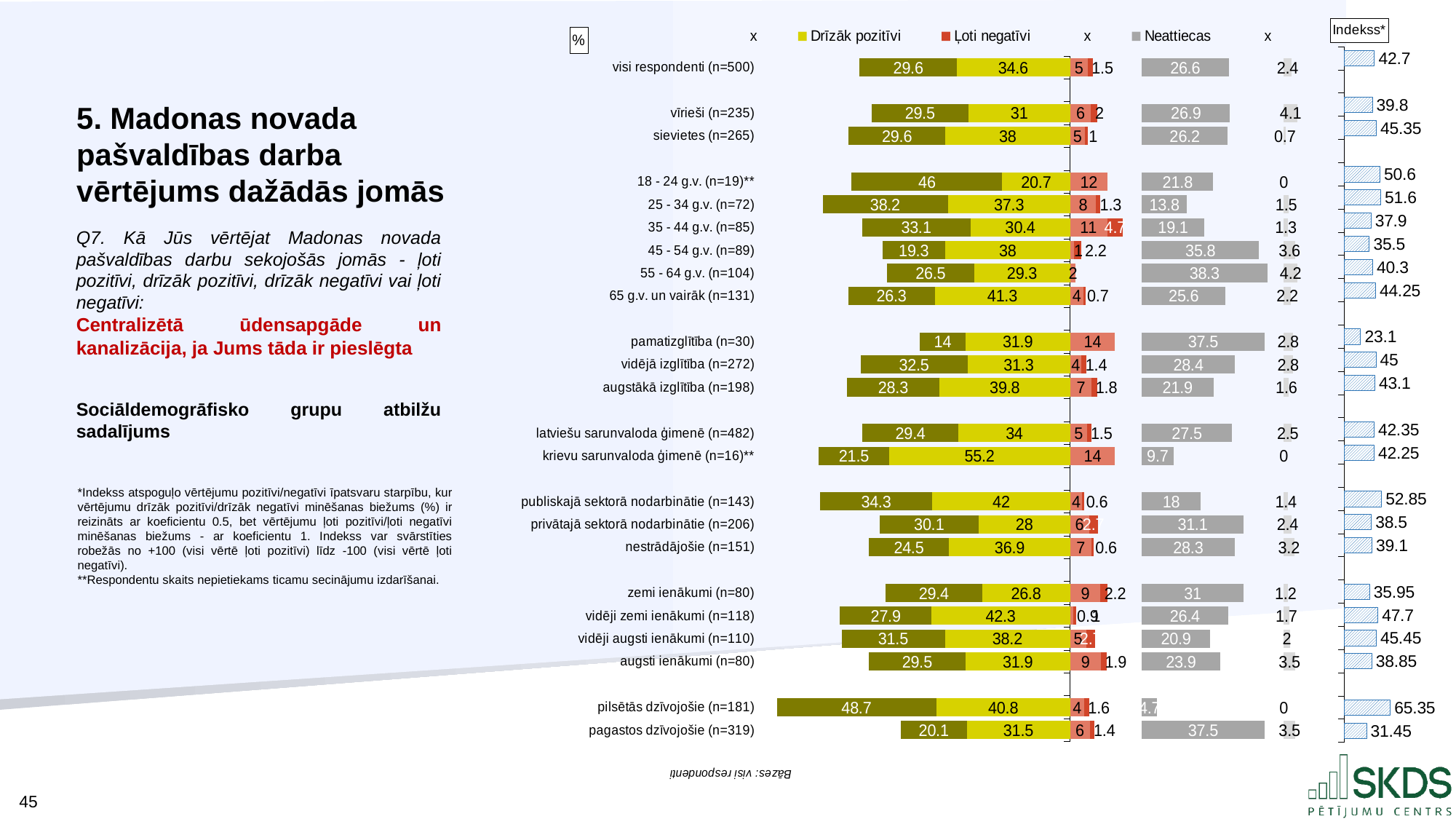
How many respondent groups are shown in the chart? 23 What is the Drīzāk pozitīvi value for publiskajā sektorā nodarbinātie (n=143)? 42 What is the Neattiecas value for 55 - 64 g.v. (n=104)? 38.3 What is the Drīzāk pozitīvi value for krievu sarunvaloda ģimenē (n=16)? 55.2 Which has a larger Neattiecas value: 45 - 54 g.v. (n=89) or 25 - 34 g.v. (n=72)? 45 - 54 g.v. (n=89) What is the difference between the Indekss values for pilsētās dzīvojošie (n=181) and pagastos dzīvojošie (n=319)? 33.9 Which group has the highest Indekss value? pilsētās dzīvojošie (n=181) Which group has the lowest Indekss value? pamatizglītība (n=30) What is the Neattiecas value for pagastos dzīvojošie (n=319)? 37.5 What is the Indekss value for visi respondenti (n=500)? 42.7 What is the Indekss value for 25 - 34 g.v. (n=72)? 51.6 What kind of chart is used to show the responses? Stacked bar chart